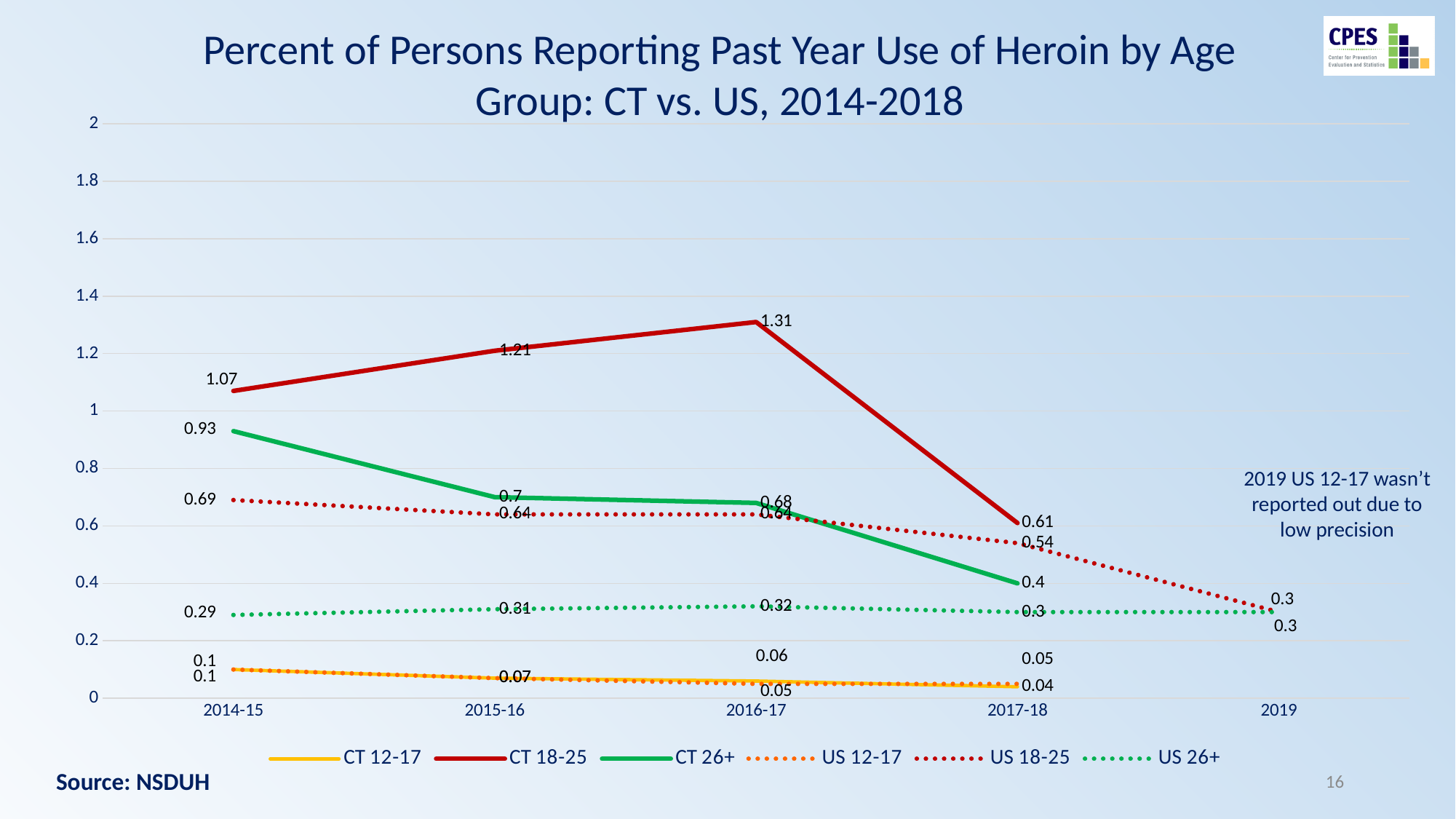
How many series does the legend list? 6 Which series reaches the highest value on the chart? CT 18-25 Which is larger in 2014-15, CT 18-25 or US 18-25? CT 18-25 What is the value for US 18-25 in 2017-18? 0.54 What is the value for CT 26+ in 2014-15? 0.93 What kind of chart is shown on the slide? Line chart According to the note on the slide, why wasn't 2019 US 12-17 reported out? Due to low precision What is the value for CT 26+ in 2017-18? 0.4 Does the CT 26+ line rise or fall from 2014-15 to 2017-18? Fall What is the difference between the CT 18-25 values for 2016-17 and 2017-18? 0.7 How many time periods are shown on the x axis? 5 What is the value for CT 18-25 in 2016-17? 1.31